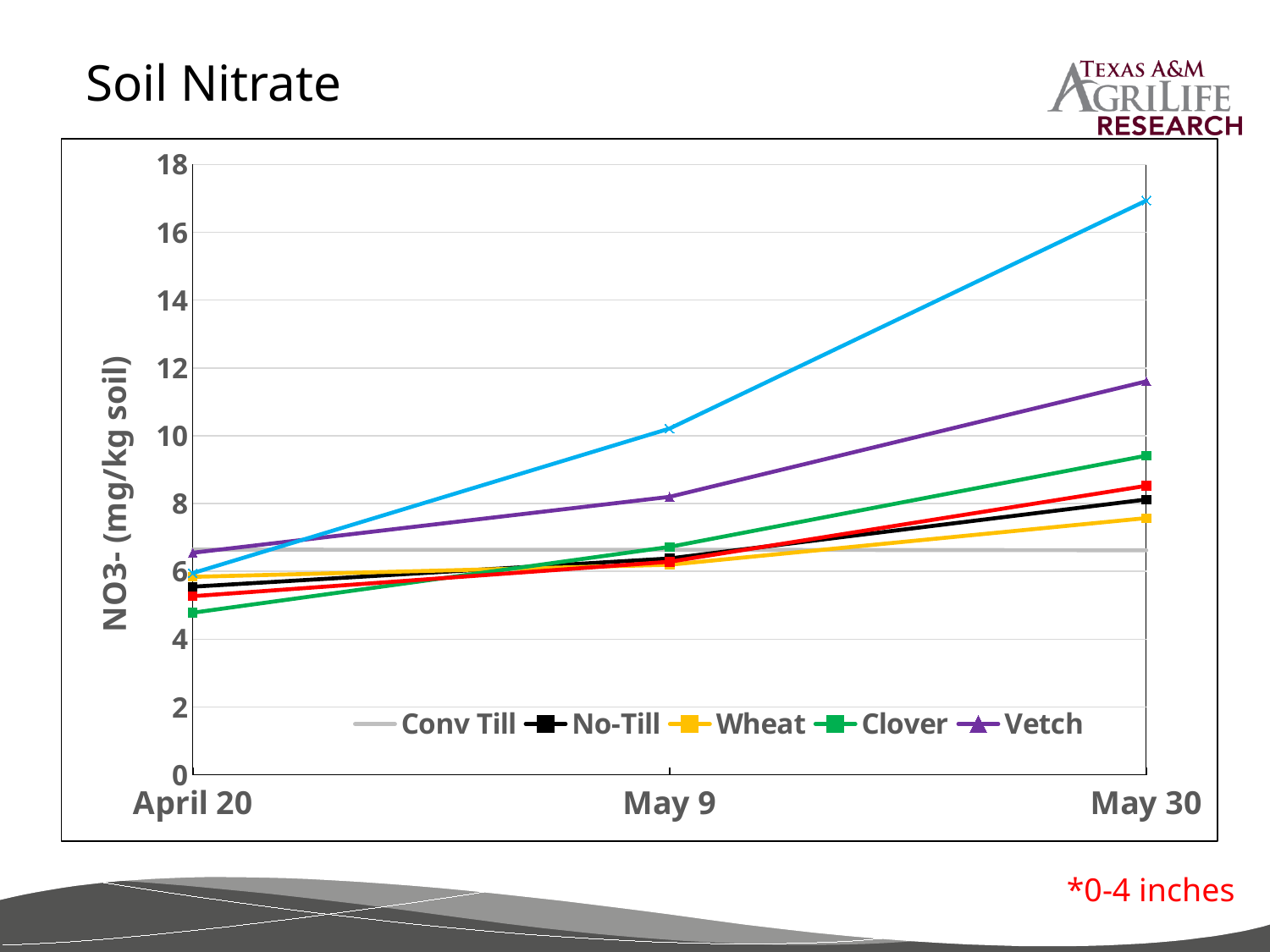
Is the value for Vetch on May 30 greater or less than 10? greater Is the value for Wheat on April 20 greater or less than 8? less What kind of chart is shown on the slide? line chart Which series has the lowest value on April 20? Clover Is the value for Clover on April 20 greater or less than 6? less Does the Vetch line rise or fall from April 20 to May 30? rise What is the label on the y axis? NO3- (mg/kg soil) On May 30, which is larger, Vetch or Clover? Vetch How many series does the legend list? 5 How many dates are shown on the x axis? 3